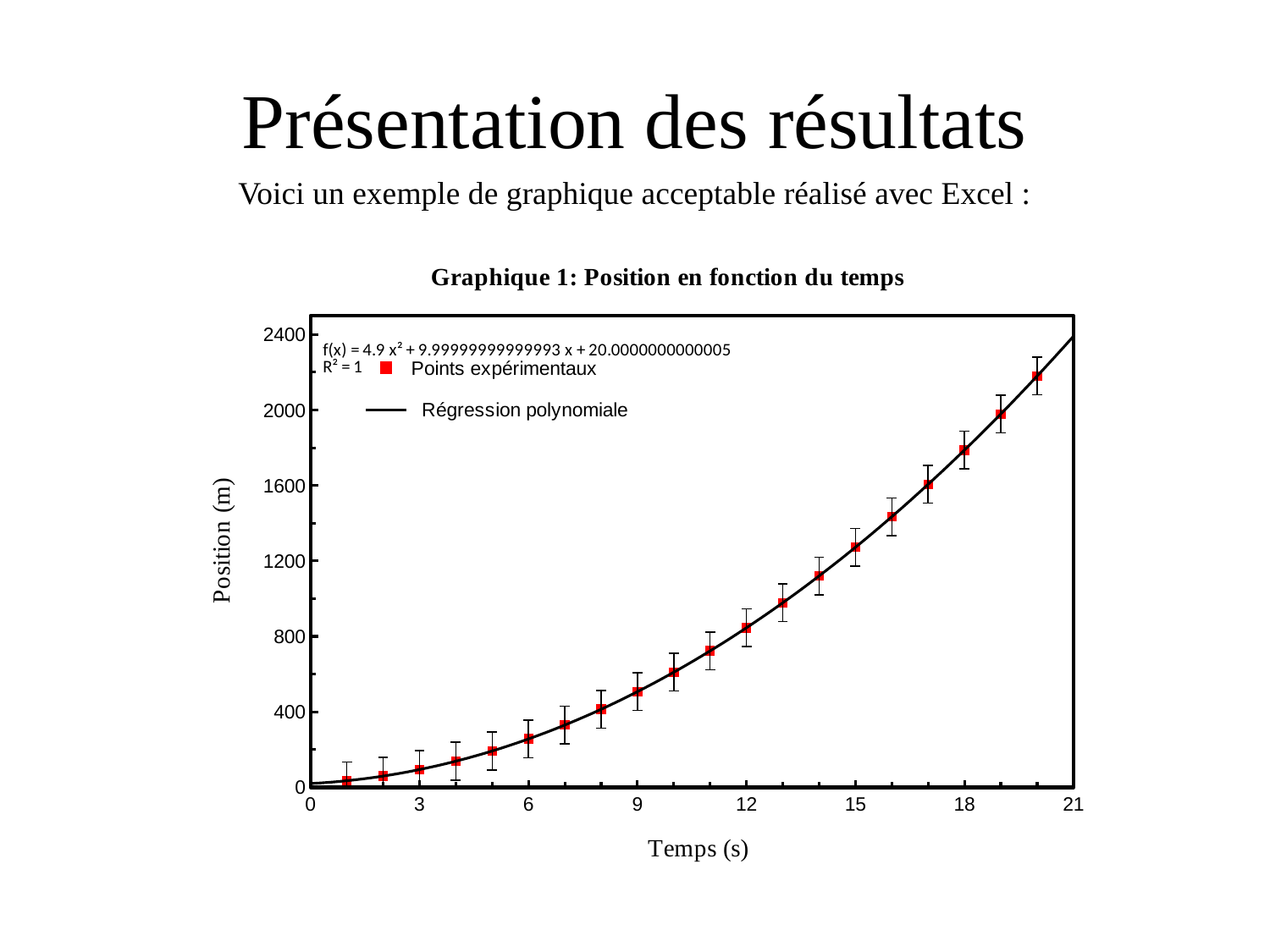
What kind of chart is shown on the slide? Scatter chart with a trendline How many entries does the chart legend list? 2 At which time (s) is the plotted position lowest? 1 Is the position value at 15 s greater or less than 1200? greater What is the title of the chart? Graphique 1: Position en fonction du temps How many experimental data points are plotted on the chart? 20 Is the position value at 5 s greater or less than 400? less Which is larger, the position at 12 s or the position at 9 s? 12 s Do the position values rise or fall as time increases along the x axis? Rise At which time (s) is the plotted position highest? 20 What R² value is displayed for the polynomial regression on the chart? R² = 1 Is the position value at 18 s greater or less than 2000? less